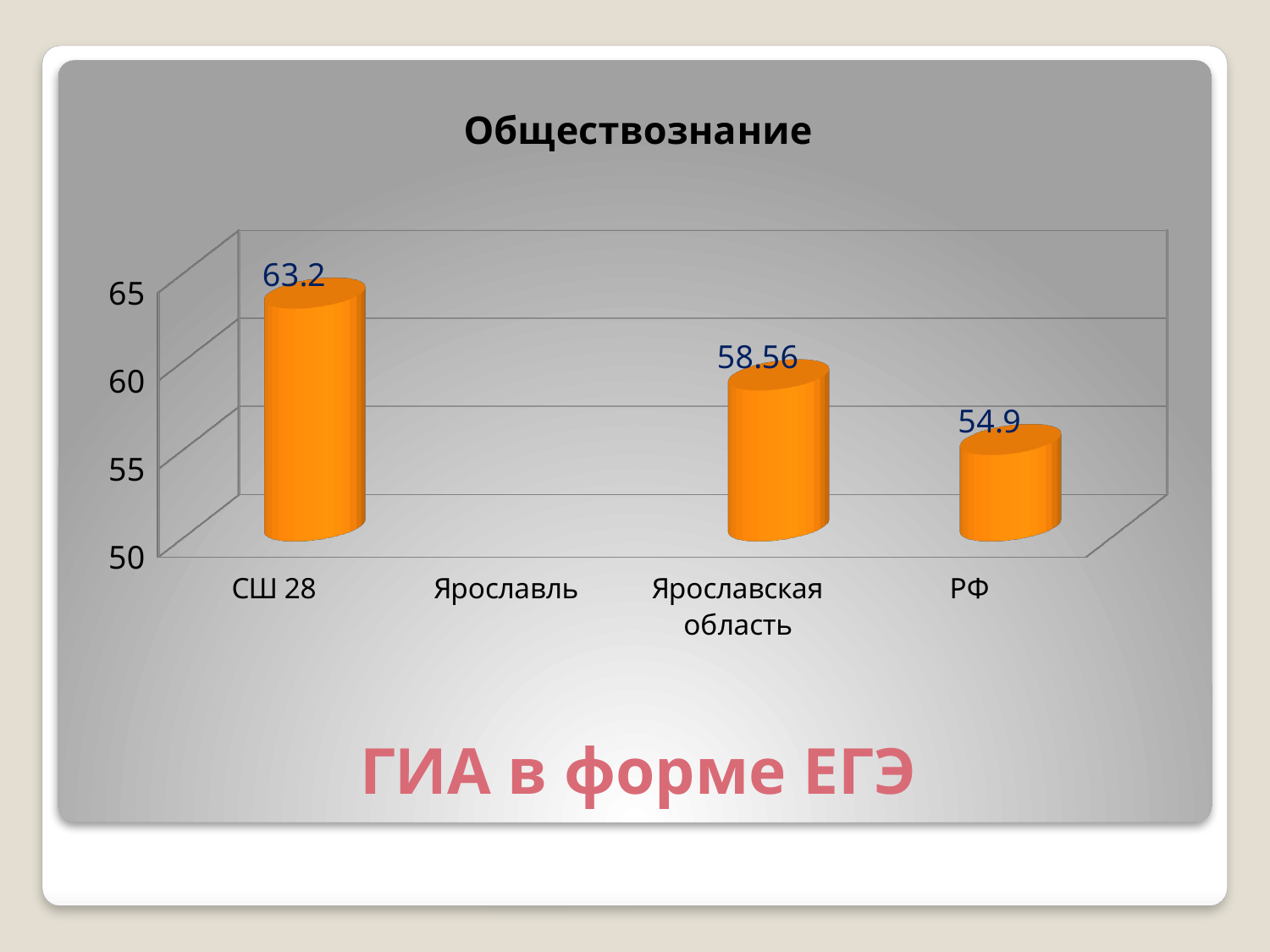
Which category has the highest value? СШ 28 What is the value for РФ? 54.9 Which is larger, the value for Ярославская область or the value for РФ? Ярославская область What kind of chart is shown on the slide? bar chart What is the value for СШ 28? 63.2 What is the value for Ярославская область? 58.56 What is the title of the chart? Обществознание Which category with a plotted bar has the lowest value? РФ What is the difference between the values for СШ 28 and Ярославская область? 4.64 How many category labels are shown on the x axis? 4 Is the value for РФ greater or less than 55? less What is the difference between the values for СШ 28 and РФ? 8.3